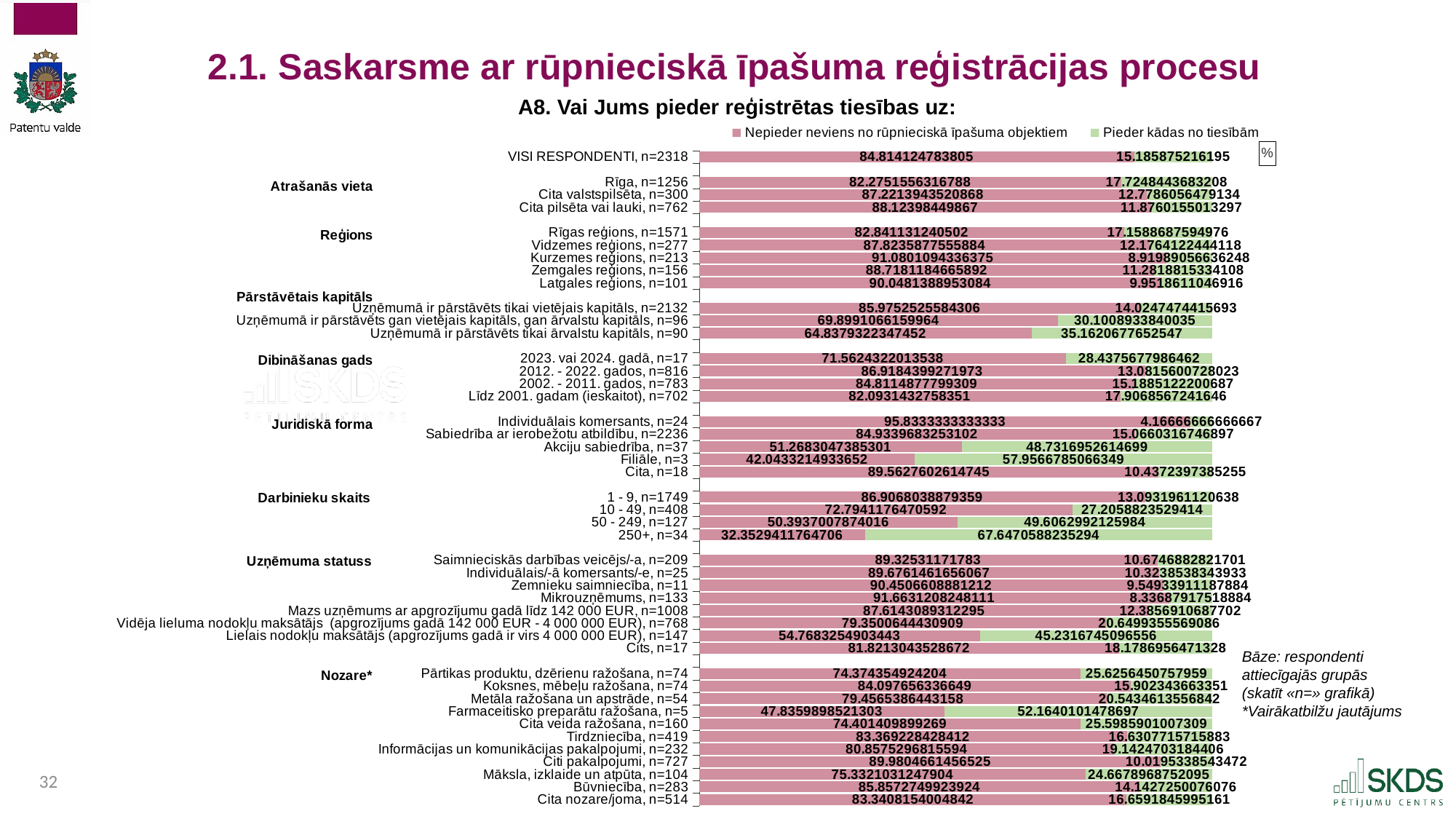
Which category has the lowest value for 'Nepieder neviens no rūpnieciskā īpašuma objektiem'? 250+, n=34 What is the value of 'Nepieder neviens no rūpnieciskā īpašuma objektiem' for Filiāle, n=3? 42.0433214933652 What is the value of 'Pieder kādas no tiesībām' for Rīga, n=1256? 17.7248443683208 What is the total of the stacked bar for VISI RESPONDENTI, n=2318? 100 How many categories are listed under the Reģions group? 5 What are the two legend entries of the chart? Nepieder neviens no rūpnieciskā īpašuma objektiem; Pieder kādas no tiesībām Which category has the highest value for 'Nepieder neviens no rūpnieciskā īpašuma objektiem'? Individuālais komersants, n=24 Which is larger for 'Nepieder neviens no rūpnieciskā īpašuma objektiem': Rīga, n=1256 or Cita pilsēta vai lauki, n=762? Cita pilsēta vai lauki, n=762 What type of chart is shown on the slide? Stacked bar chart How many series does the legend list? 2 What is the value of 'Pieder kādas no tiesībām' for 250+, n=34? 67.6470588235294 What is the value of 'Nepieder neviens no rūpnieciskā īpašuma objektiem' for VISI RESPONDENTI, n=2318? 84.814124783805